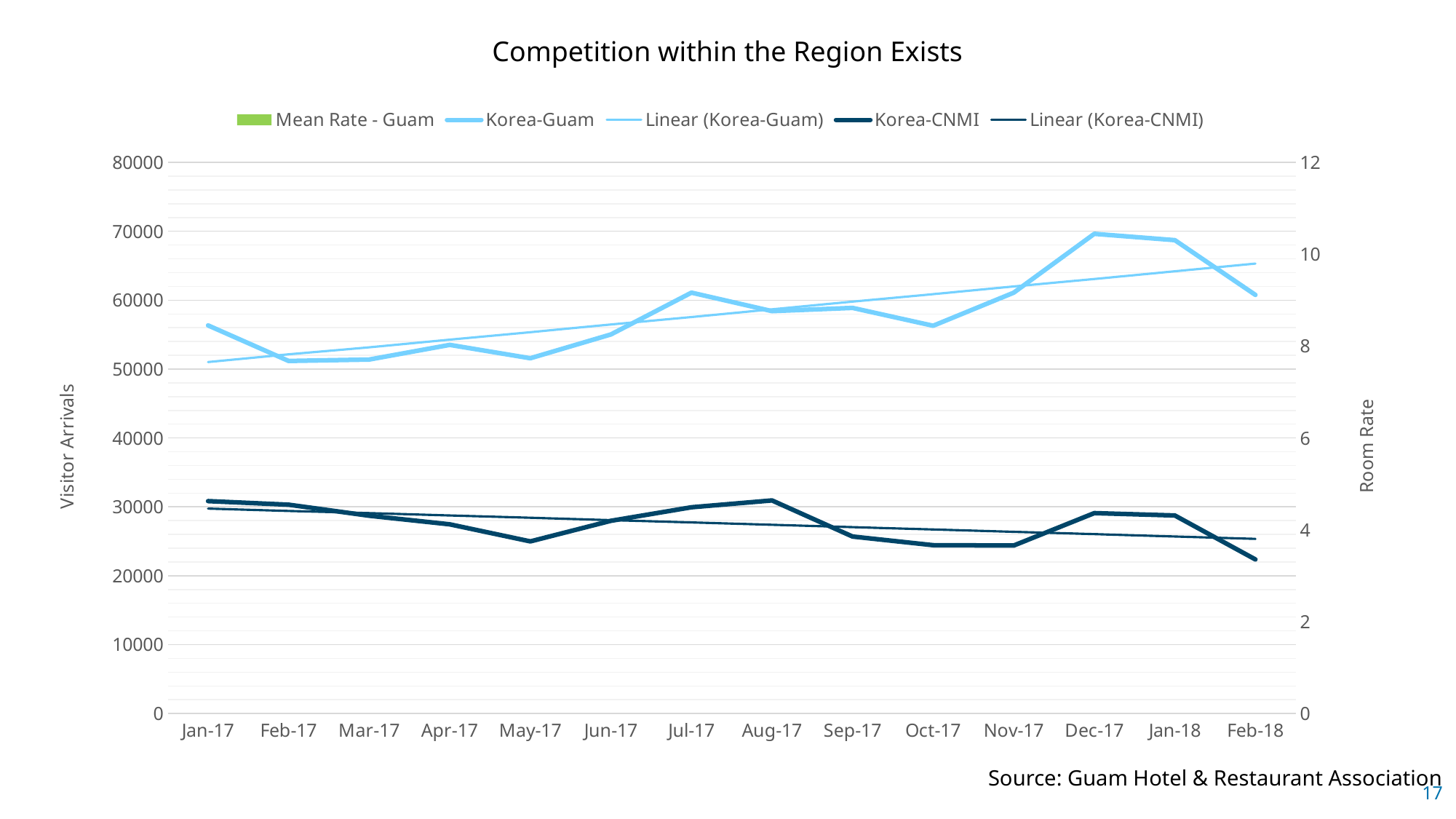
Is the Korea-CNMI value for Feb-18 greater or less than 30000? less How many months are shown along the x axis? 14 In which month does the Korea-CNMI series reach its lowest value? Feb-18 In which month does the Korea-Guam series reach its highest value? Dec-17 How many entries does the legend list? 5 Which is larger for Korea-Guam, the value in Dec-17 or the value in Feb-18? Dec-17 Is the Korea-Guam value for Dec-17 greater or less than 60000? greater Which series has the larger value in Jul-17, Korea-Guam or Korea-CNMI? Korea-Guam What is the title of the left vertical axis? Visitor Arrivals What kind of chart is shown on the slide? line chart Is the Korea-Guam value for Jan-17 greater or less than 50000? greater Does the Linear (Korea-CNMI) trendline rise or fall from Jan-17 to Feb-18? fall